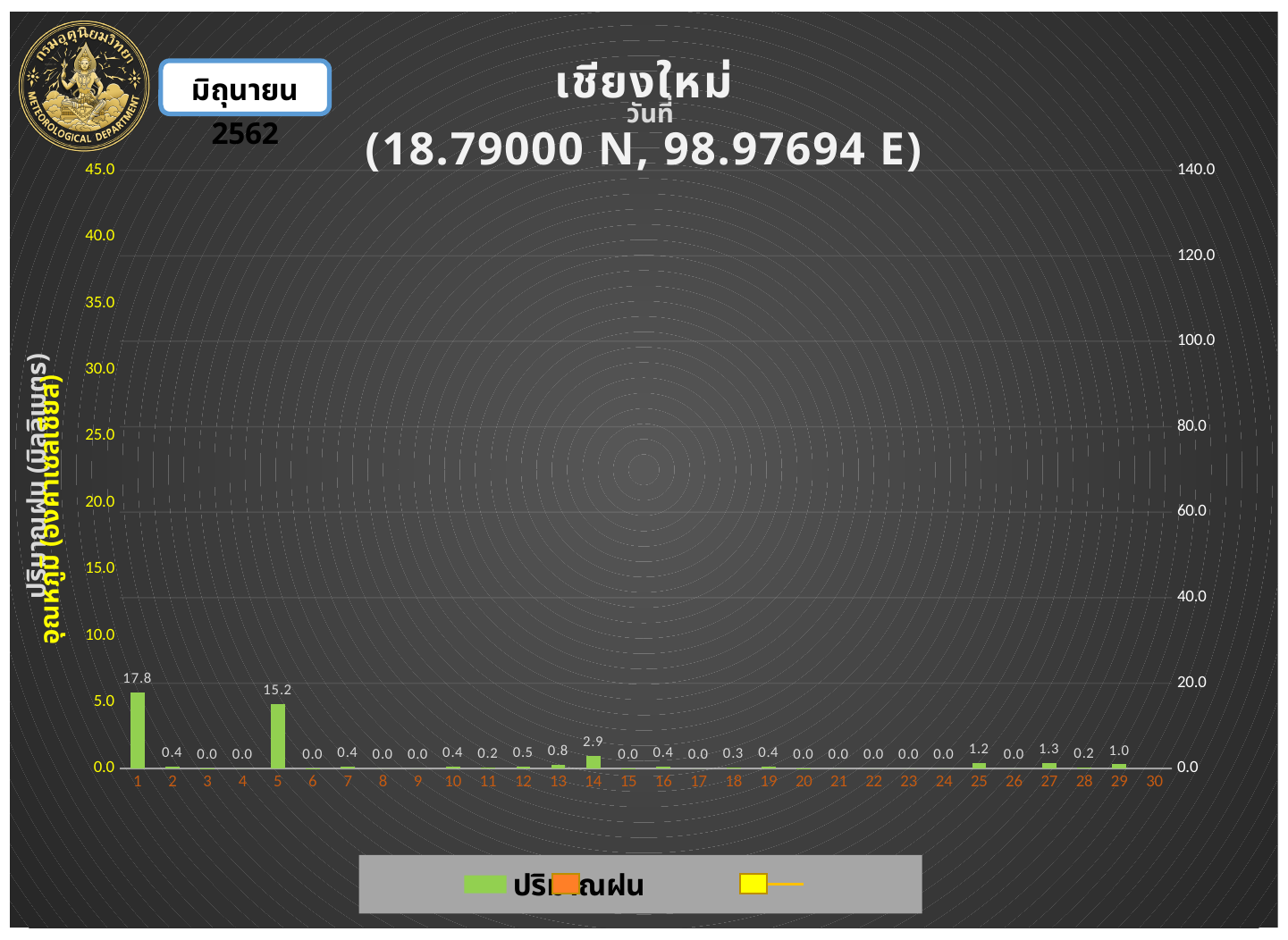
What is the rainfall value shown for day 5? 15.2 What is the rainfall value shown for day 29? 1.0 What is the rainfall value shown for day 27? 1.3 What is the rainfall value shown for day 1? 17.8 Which day has the highest rainfall value? 1 How many days are shown on the x axis? 30 What kind of chart is shown on the slide? bar chart What coordinates are given in the chart title? 18.79000 N, 98.97694 E What is the rainfall value shown for day 14? 2.9 What is the difference between the rainfall values for day 1 and day 5? 2.6 Is the rainfall value for day 1 greater or less than 20.0 on the right axis? less Which is larger, the rainfall value for day 14 or for day 25? day 14